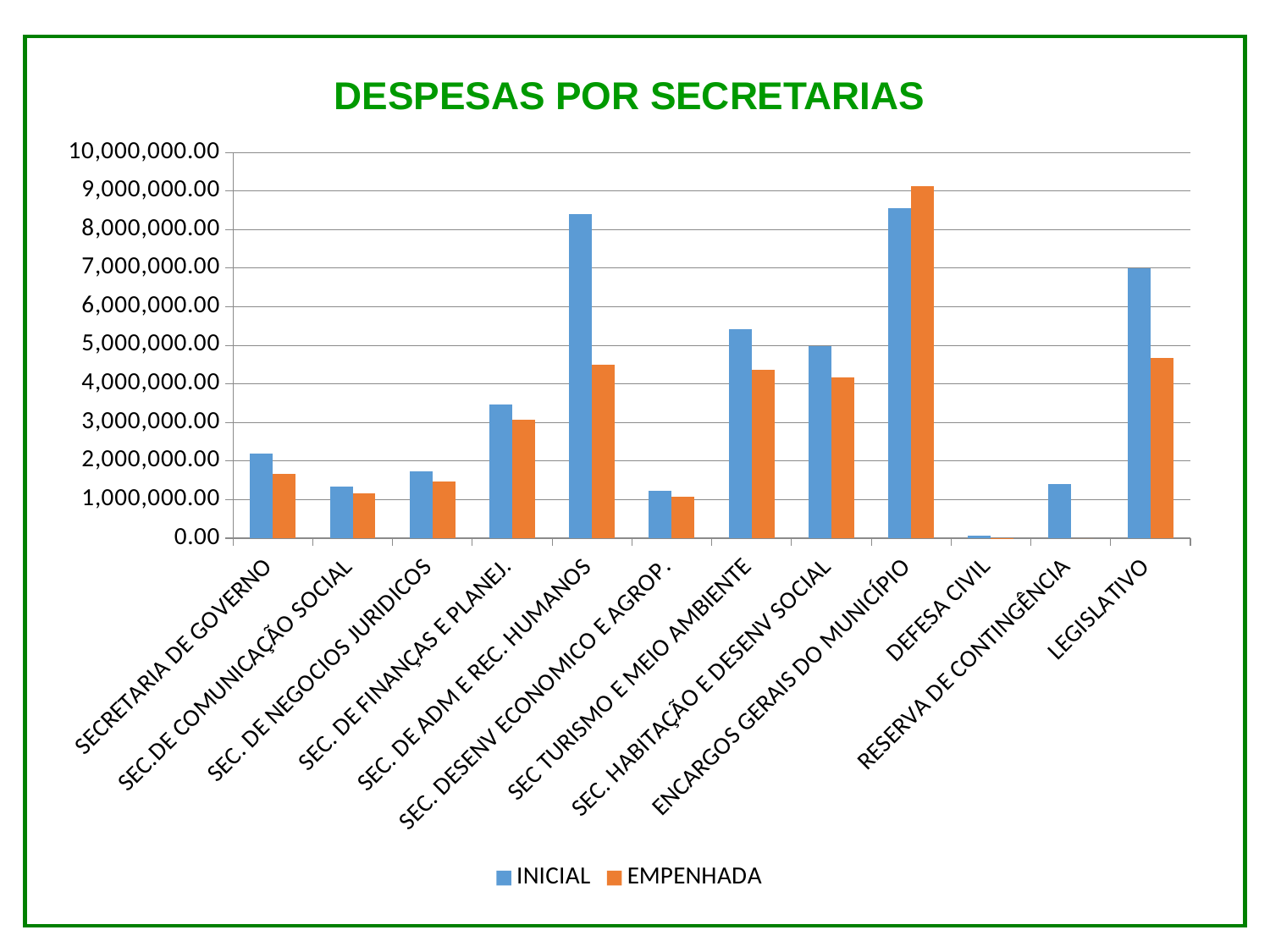
Is the INICIAL value for SEC. DE ADM E REC. HUMANOS greater or less than 8,000,000.00? greater How many series does the legend list? 2 What kind of chart is shown on the slide? bar chart Is the INICIAL value for SEC TURISMO E MEIO AMBIENTE greater or less than 5,000,000.00? greater For ENCARGOS GERAIS DO MUNICÍPIO, which is larger, INICIAL or EMPENHADA? EMPENHADA How many categories (secretarias) are shown on the x axis? 12 Is the EMPENHADA value for LEGISLATIVO greater or less than 4,000,000.00? greater For SEC. DE ADM E REC. HUMANOS, which is larger, INICIAL or EMPENHADA? INICIAL Which category has the lowest INICIAL value? DEFESA CIVIL Which category has the highest EMPENHADA value? ENCARGOS GERAIS DO MUNICÍPIO What is the title of the chart? DESPESAS POR SECRETARIAS